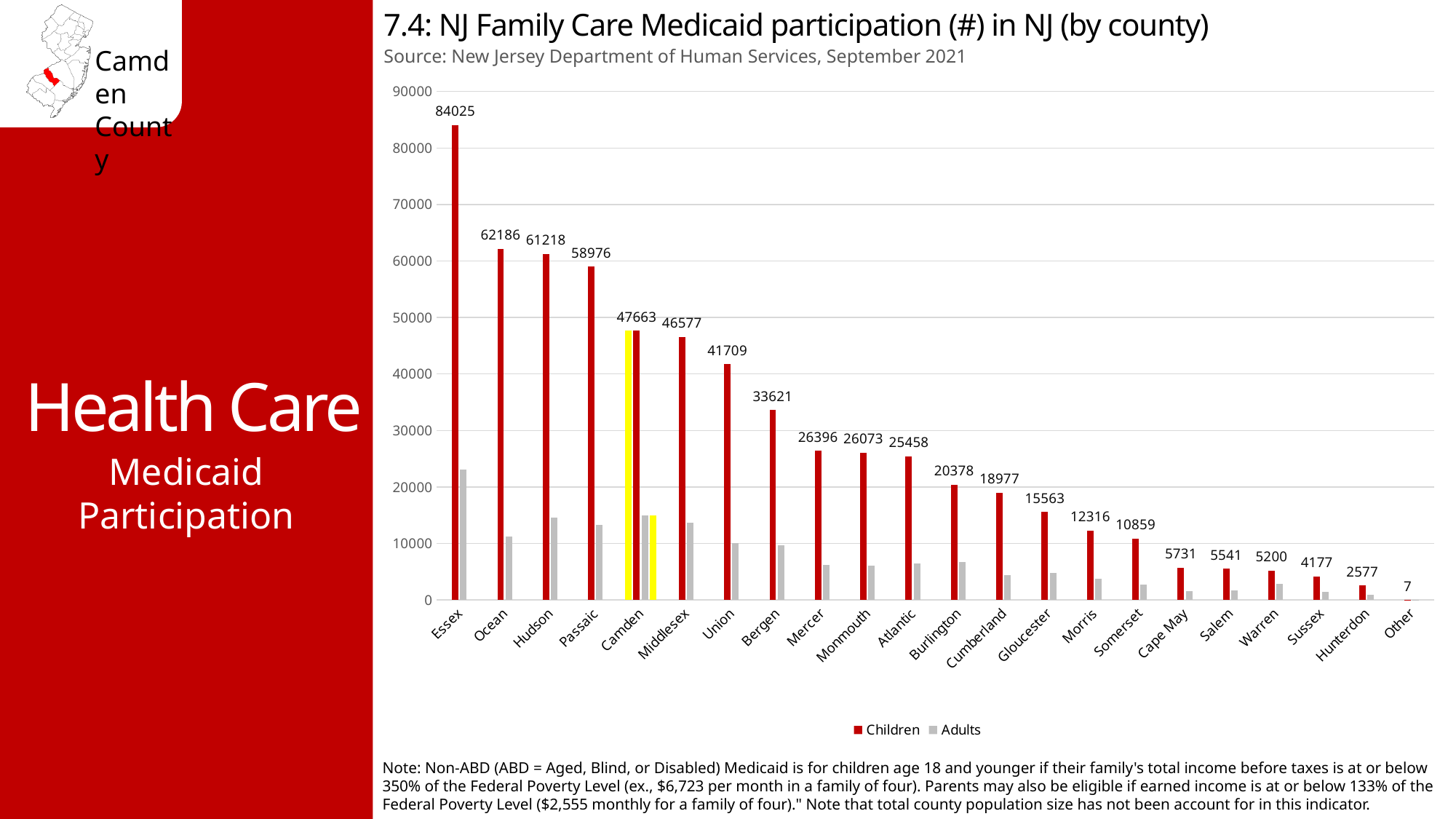
Is the Adults value for Essex greater or less than 20000? greater Do the Children values rise or fall from left to right along the x axis? fall What is the difference between the Children values for Essex and Ocean? 21839 What is the Children value for Essex? 84025 Which county has the highest Children value? Essex What is the difference between the Children values for Ocean and Hudson? 968 What is the Children value for Camden? 47663 What kind of chart is shown on the slide? bar chart Which has a larger Children value, Camden or Middlesex? Camden How many series does the legend list? 2 Which category has the lowest Children value? Other How many categories are shown on the x axis? 22